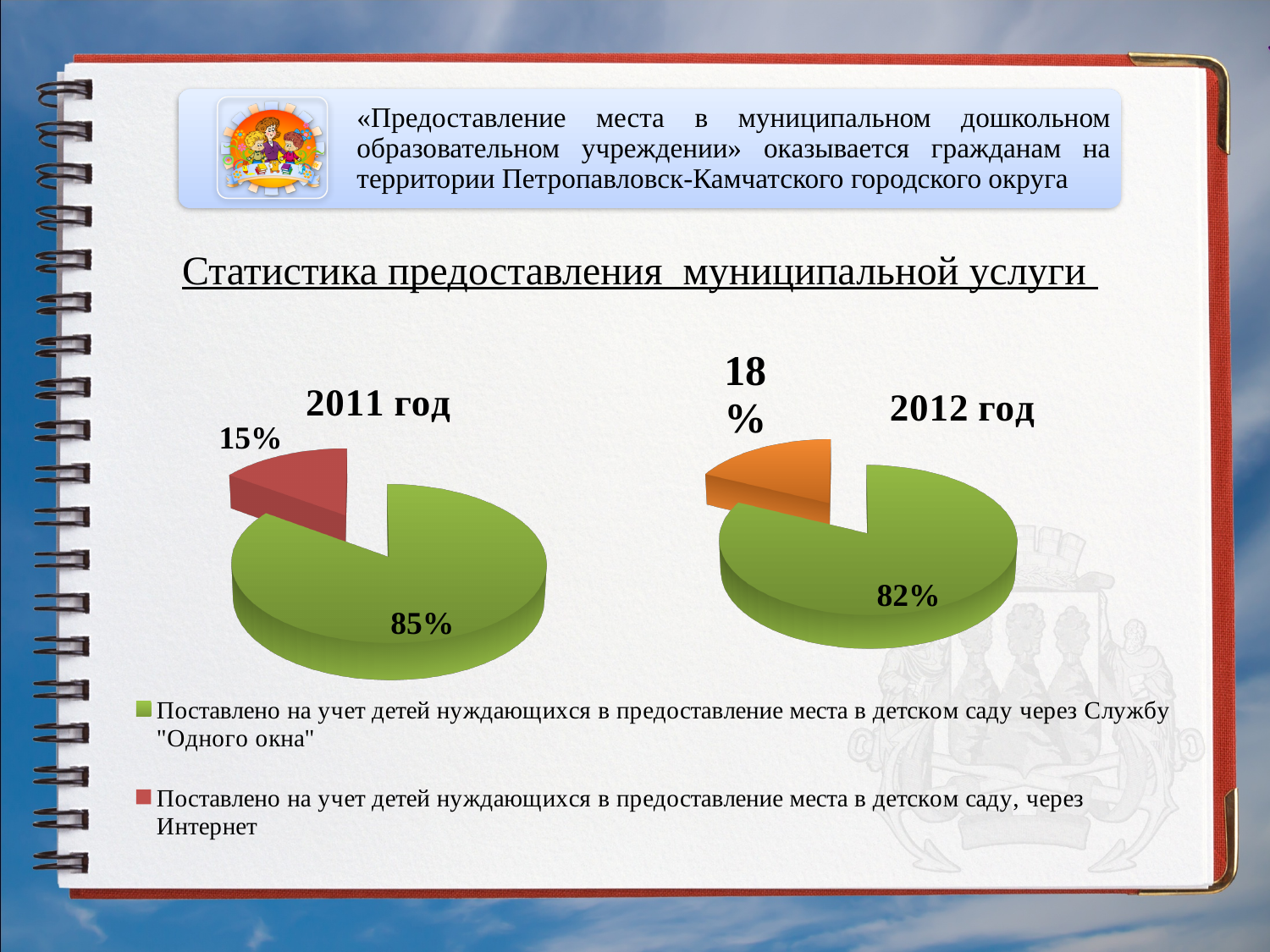
Which is larger: the green slice in the "2011 год" chart or the green slice in the "2012 год" chart? 2011 год (85%) In the "2012 год" chart, what share is shown for the green slice (children registered through the "Одного окна" service)? 82% In the "2012 год" chart, which slice is the smallest? 18% In the "2012 год" chart, what share is shown for the small orange slice? 18% In the "2011 год" chart, what share is shown for the green slice (children registered through the "Одного окна" service)? 85% What is the title of the "2011 год" chart's neighbouring chart on the right? 2012 год How many slices does the "2012 год" pie chart have? 2 In the "2011 год" chart, what is the difference between the two slices' shares? 70% How many entries does the legend below the charts list? 2 In the "2011 год" chart, what share is shown for the red slice (children registered through the Internet)? 15% In the "2011 год" chart, which slice is the largest? 85% (через Службу "Одного окна") What kind of chart is the "2011 год" chart? pie chart